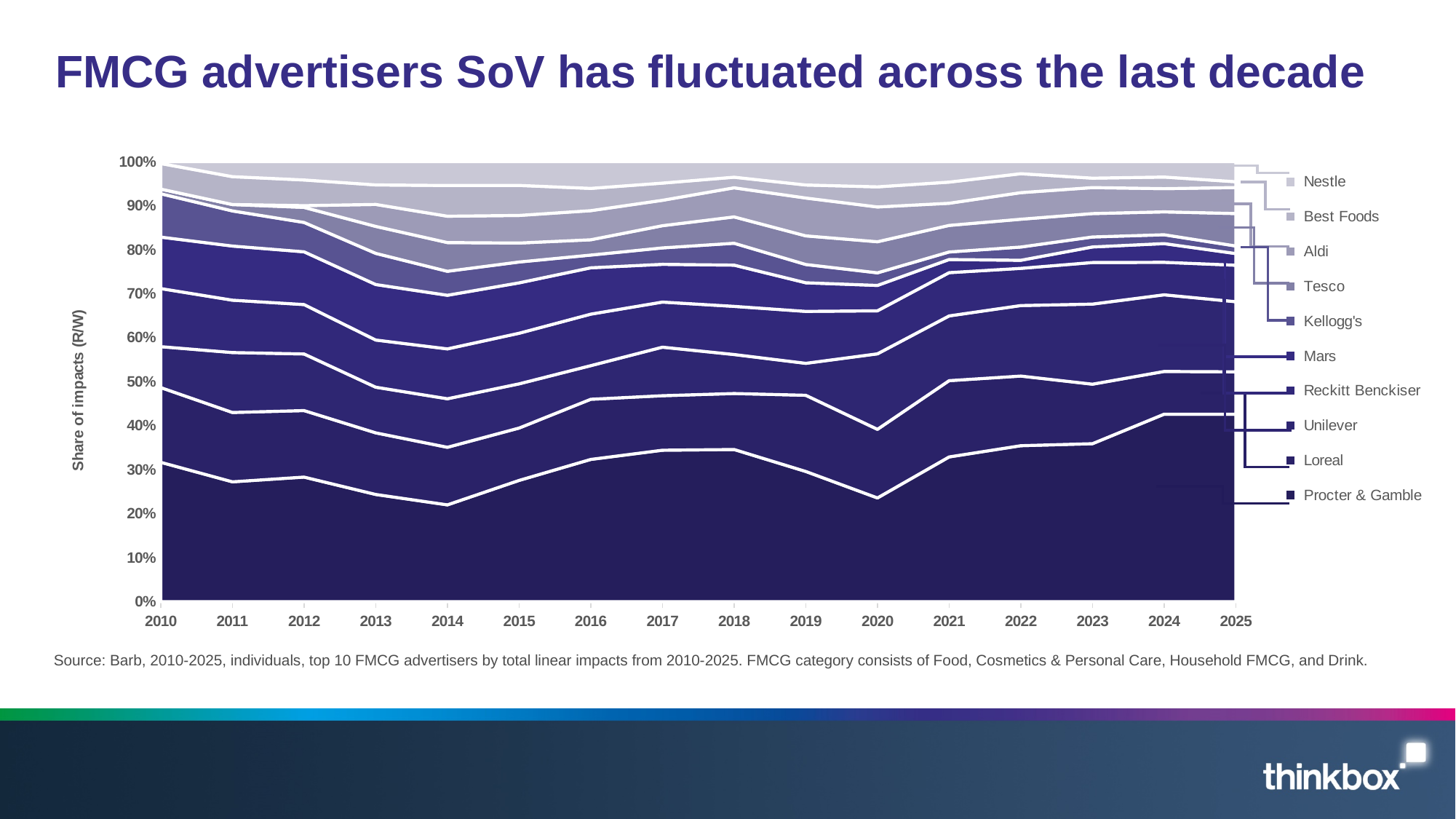
What is the label on the y axis? Share of impacts (R/W) Is the share of impacts for Procter & Gamble in 2020 greater or less than 30%? less Which is larger, Procter & Gamble's share of impacts in 2024 or in 2014? 2024 Is the share of impacts for Procter & Gamble in 2024 greater or less than 40%? greater How many years are shown along the x axis? 16 How many advertisers does the legend list? 10 What is the first year shown on the x axis? 2010 Is the share of impacts for Procter & Gamble in 2014 greater or less than 30%? less What is the last year shown on the x axis? 2025 What kind of chart is shown on the slide? Stacked area chart Does Procter & Gamble's share of impacts rise or fall between 2020 and 2024? Rise